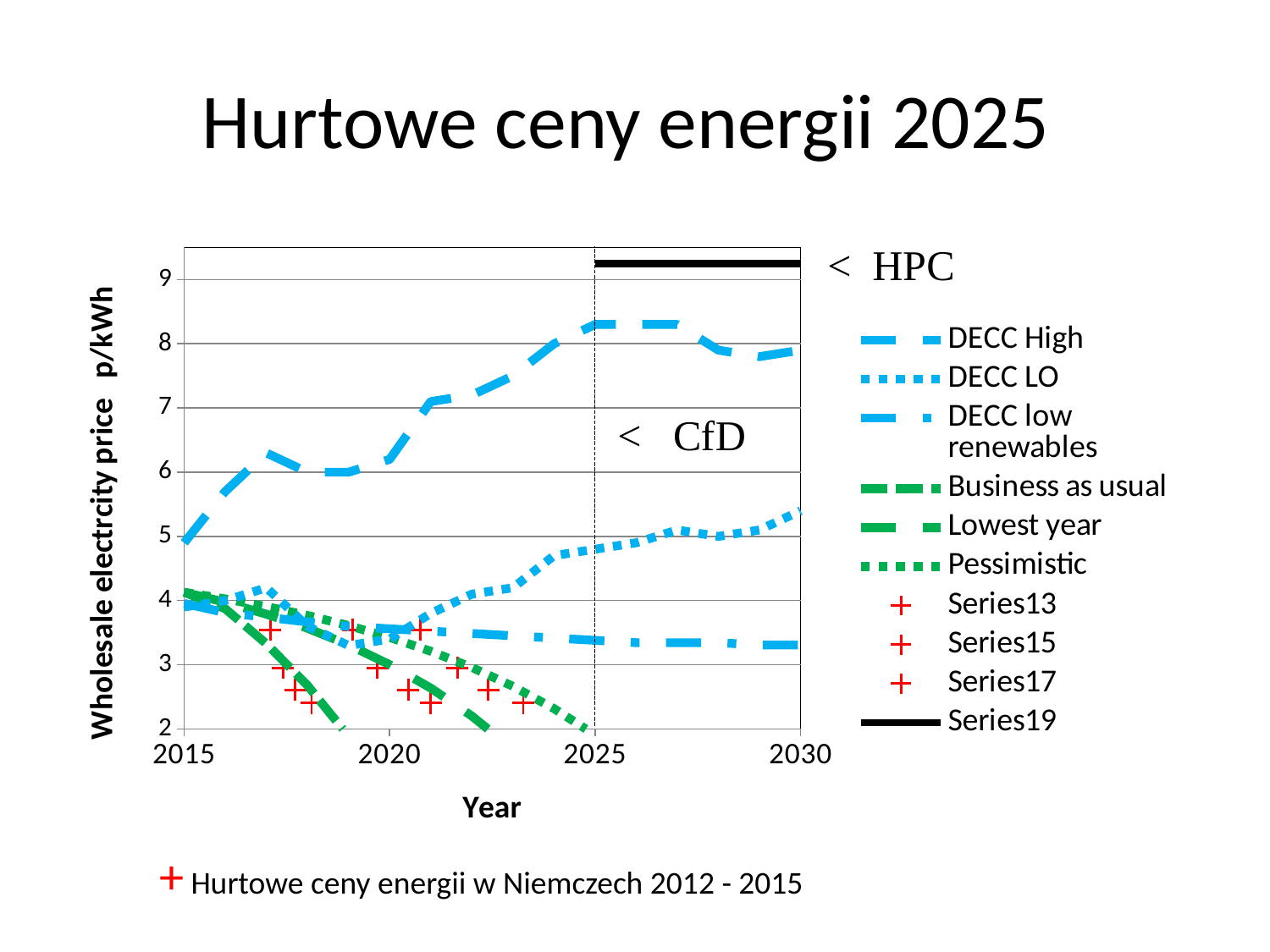
Which is larger in 2025, DECC High or DECC LO? DECC High Is the value for DECC LO in 2030 greater or less than 5? greater How many series does the legend list? 10 What kind of chart is shown on the slide? line chart Does the DECC High series rise or fall between 2015 and 2025? rise What is the label of the x axis? Year Is the value for DECC low renewables in 2030 greater or less than 4? less Does the DECC low renewables series rise or fall between 2015 and 2030? fall Is the value of the Series19 line greater or less than 9? greater Which of the DECC series has the lowest value in 2030? DECC low renewables What is the title of the slide's chart area? Hurtowe ceny energii 2025